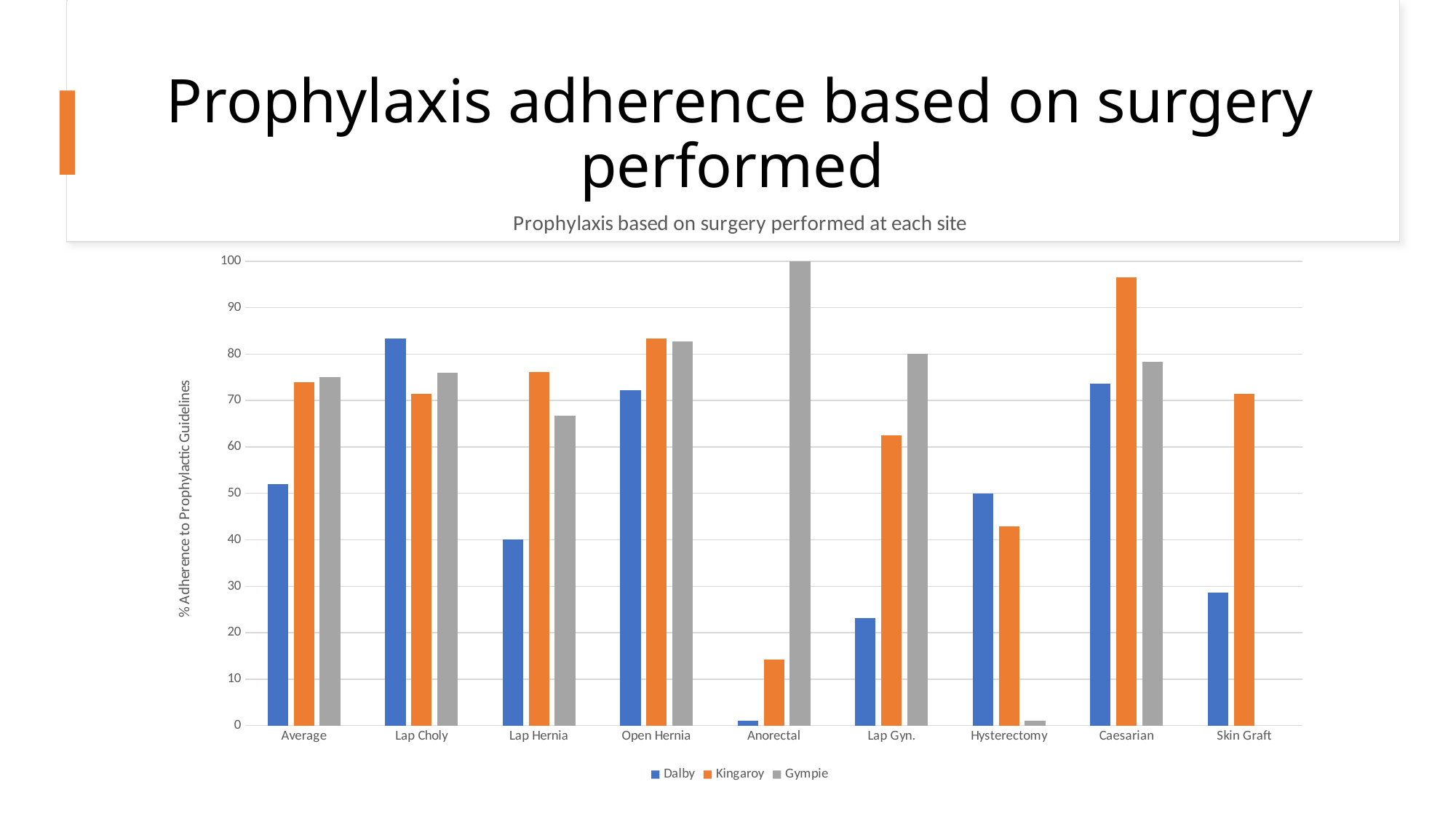
What is the title of the y axis? % Adherence to Prophylactic Guidelines What is the adherence value for Gympie at Anorectal? 100 Is the value for Dalby at Skin Graft greater or less than 30? less For Lap Gyn., which is larger: Kingaroy or Gympie? Gympie How many series does the legend list? 3 Is the value for Dalby at Anorectal greater or less than 10? less For Lap Choly, which is larger: Dalby or Kingaroy? Dalby Which site has the lowest adherence for Caesarian? Dalby How many surgery categories are shown on the x axis? 9 Is the value for Kingaroy at Caesarian greater or less than 90? greater What kind of chart is shown on the slide? Bar chart Which site has the highest adherence for Anorectal surgery? Gympie